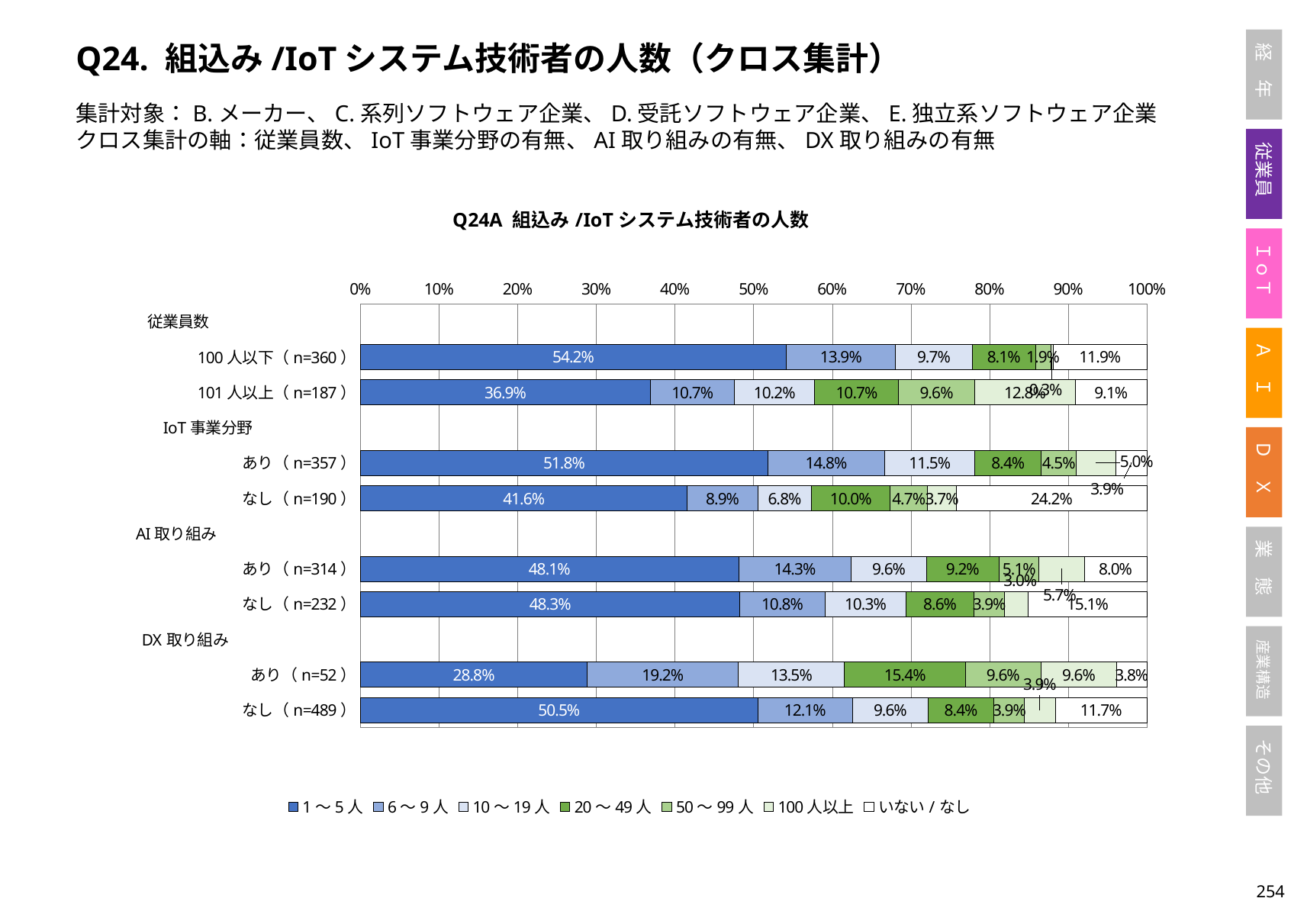
What is the share of 1～5人 for the 101人以上 (n=187) group? 36.9% What is the share of 1～5人 for the 100人以下 (n=360) group? 54.2% How many bars (respondent groups) are plotted in the Q24A chart? 8 What is the difference in the 1～5人 share between the 100人以下 group and the 101人以上 group? 17.3 percentage points How many series does the legend of the Q24A chart list? 7 What is the share of 20～49人 for the DX取り組み あり (n=52) group? 15.4% Which group has the lowest share of 1～5人? DX取り組み あり (n=52) Which has a larger share of 1～5人: IoT事業分野 あり (n=357) or IoT事業分野 なし (n=190)? IoT事業分野 あり (n=357) What type of chart is shown on the slide? Stacked bar chart What is the share of いない/なし for the IoT事業分野 なし (n=190) group? 24.2% Which group has the highest share of 1～5人? 100人以下 (n=360) Is the 1～5人 share for the IoT事業分野 なし (n=190) group greater or less than 50%? less